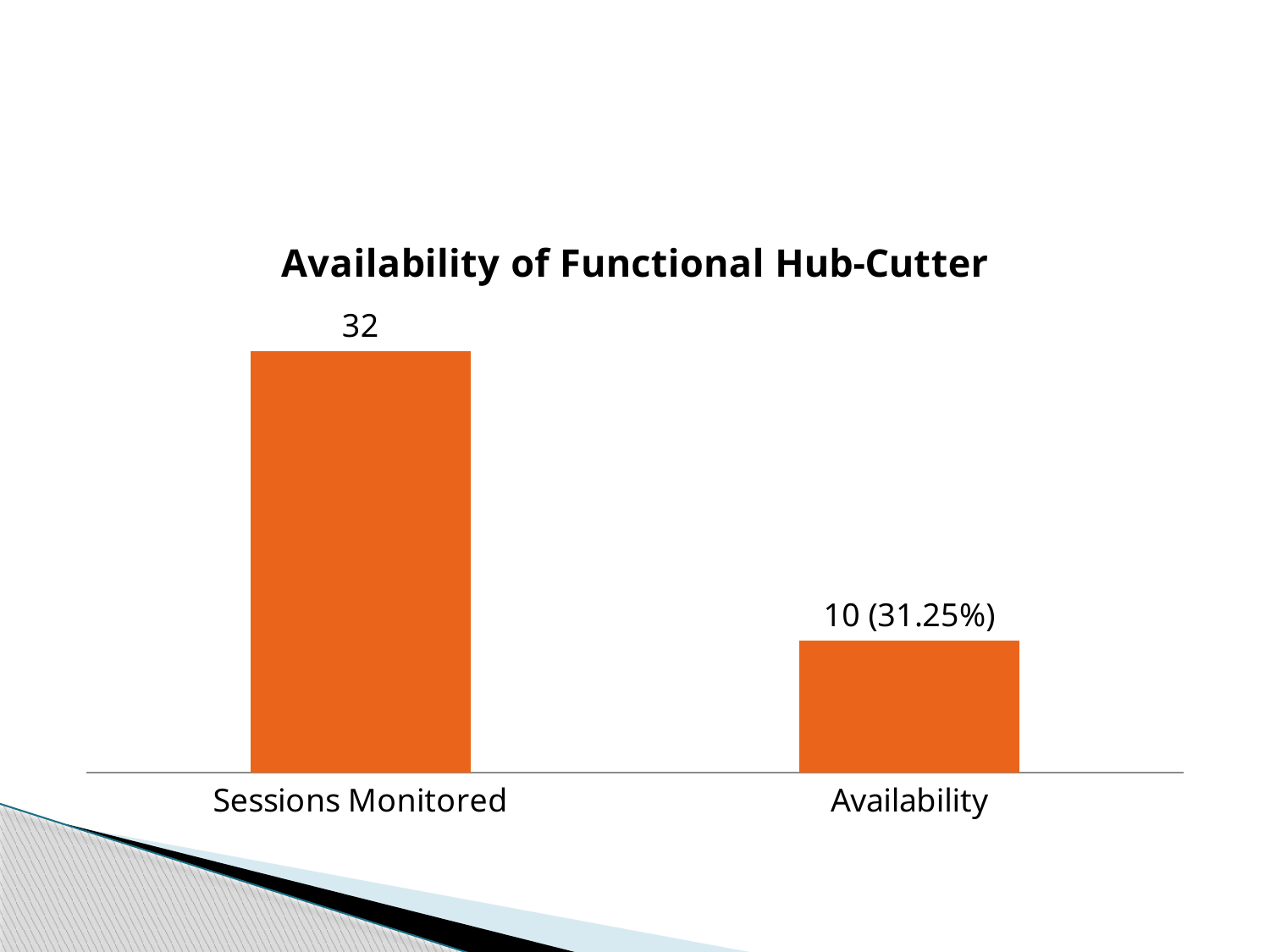
What percentage is shown in the Availability data label? 31.25% What is the difference between the Sessions Monitored value and the Availability value? 22 What kind of chart is shown on the slide? Bar chart Which category has the lowest value? Availability What colour are the bars in the chart? Orange What is the title of the chart? Availability of Functional Hub-Cutter How many categories are shown in the chart? 2 Which is larger, Sessions Monitored or Availability? Sessions Monitored Which category has the highest value? Sessions Monitored What is the data label shown on the Availability bar? 10 (31.25%) What is the value for Sessions Monitored? 32